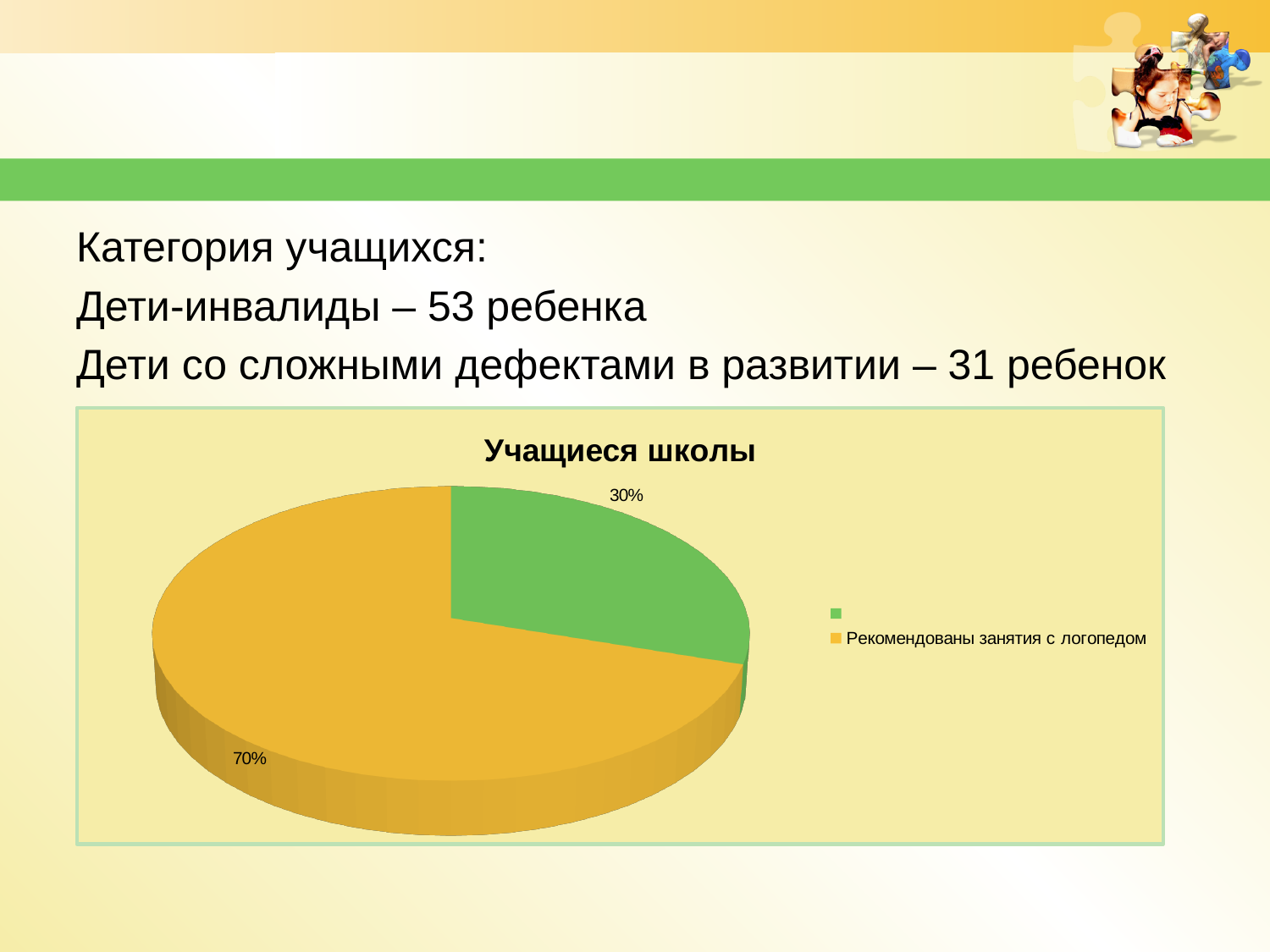
What is the title of the chart? Учащиеся школы Is the share of the green slice greater or less than 50%? less What is the percentage shown on the smallest slice of the pie? 30% How many slices does the pie chart have? 2 By how many percentage points does the orange slice exceed the green slice? 40 Which slice is the largest in the pie chart? Рекомендованы занятия с логопедом What share of the pie does the green slice represent? 30% What share of the pie is labelled "Рекомендованы занятия с логопедом"? 70% What colour is the slice labelled "Рекомендованы занятия с логопедом"? orange Which slice is larger: the green slice or the orange slice? the orange slice What kind of chart is shown on the slide? pie chart